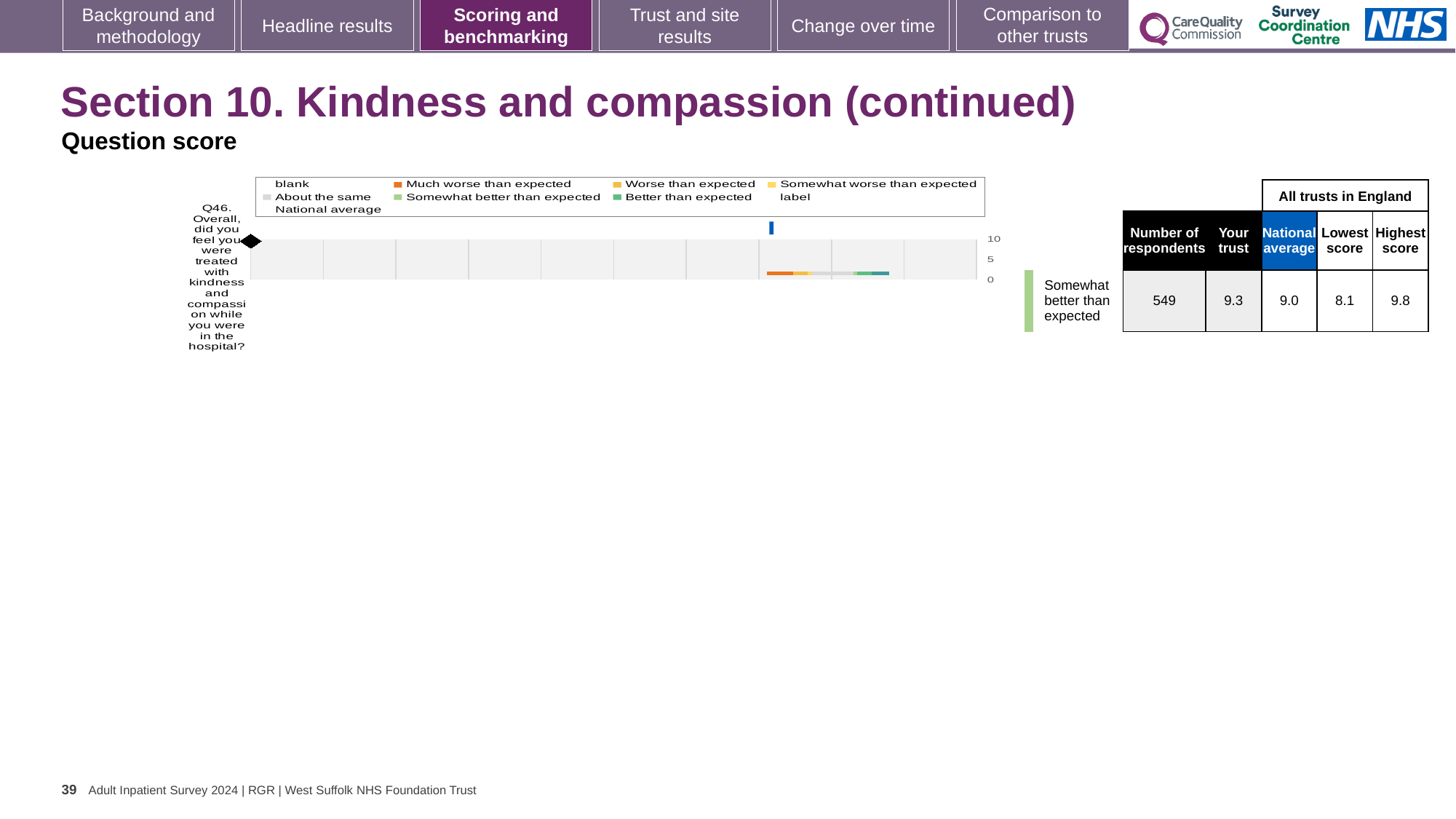
What kind of chart is shown on the slide? bar chart What is the national average score for Q46? 9.0 What is the highest score among all trusts in England for Q46? 9.8 How many respondents answered Q46? 549 What is the highest tick value shown on the chart's score axis? 10 Which question number is plotted on the chart? Q46 What is the difference between the 'Your trust' score and the national average for Q46? 0.3 How many questions (categories) are plotted on the chart? 1 What is the lowest score among all trusts in England for Q46? 8.1 Which is larger for Q46, the 'Your trust' score or the national average? Your trust Which benchmark category is the trust's Q46 score placed in? Somewhat better than expected What is the 'Your trust' score for Q46? 9.3